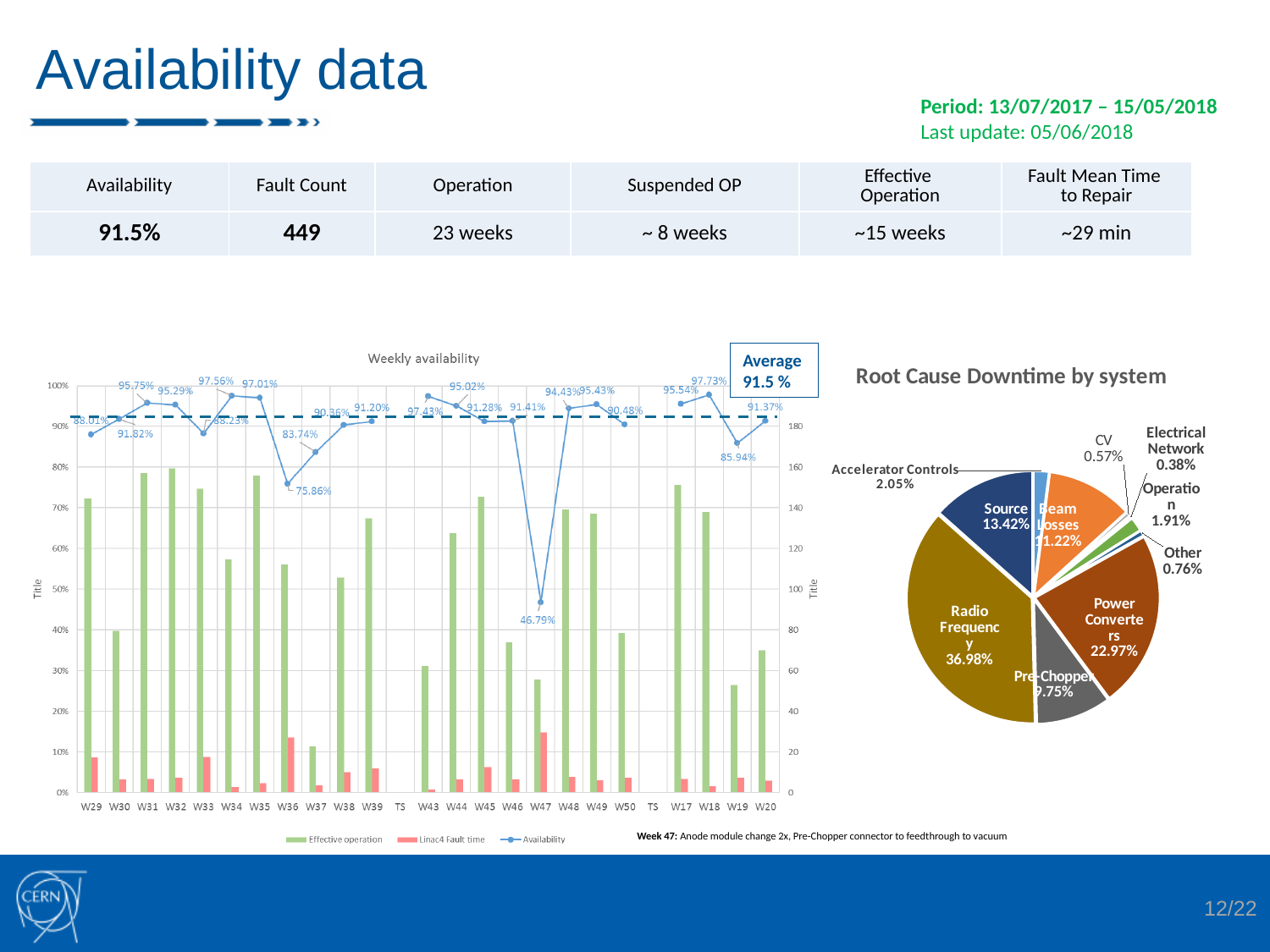
In the Root Cause Downtime by system pie chart, which system accounts for the largest share of downtime? Radio Frequency In the Root Cause Downtime by system pie chart, which system has the smallest share? Electrical Network How many series does the legend of the Weekly availability chart list? 3 In the Weekly availability chart, which week has the lowest availability? W47 In the Root Cause Downtime by system pie chart, how much larger is the Power Converters share than the Source share? 9.55% How many slices does the Root Cause Downtime by system pie chart have? 10 In the Weekly availability chart, is the Effective operation value for W30 greater or less than 50%? less In the Weekly availability chart, which week has the highest availability? W18 In the Weekly availability chart, which week has the higher availability, W31 or W33? W31 In the Weekly availability chart, what is the difference between the availability of W36 and W47? 29.07% In the Weekly availability chart, what is the availability value for W36? 75.86% In the Root Cause Downtime by system pie chart, what share is attributed to Radio Frequency? 36.98%